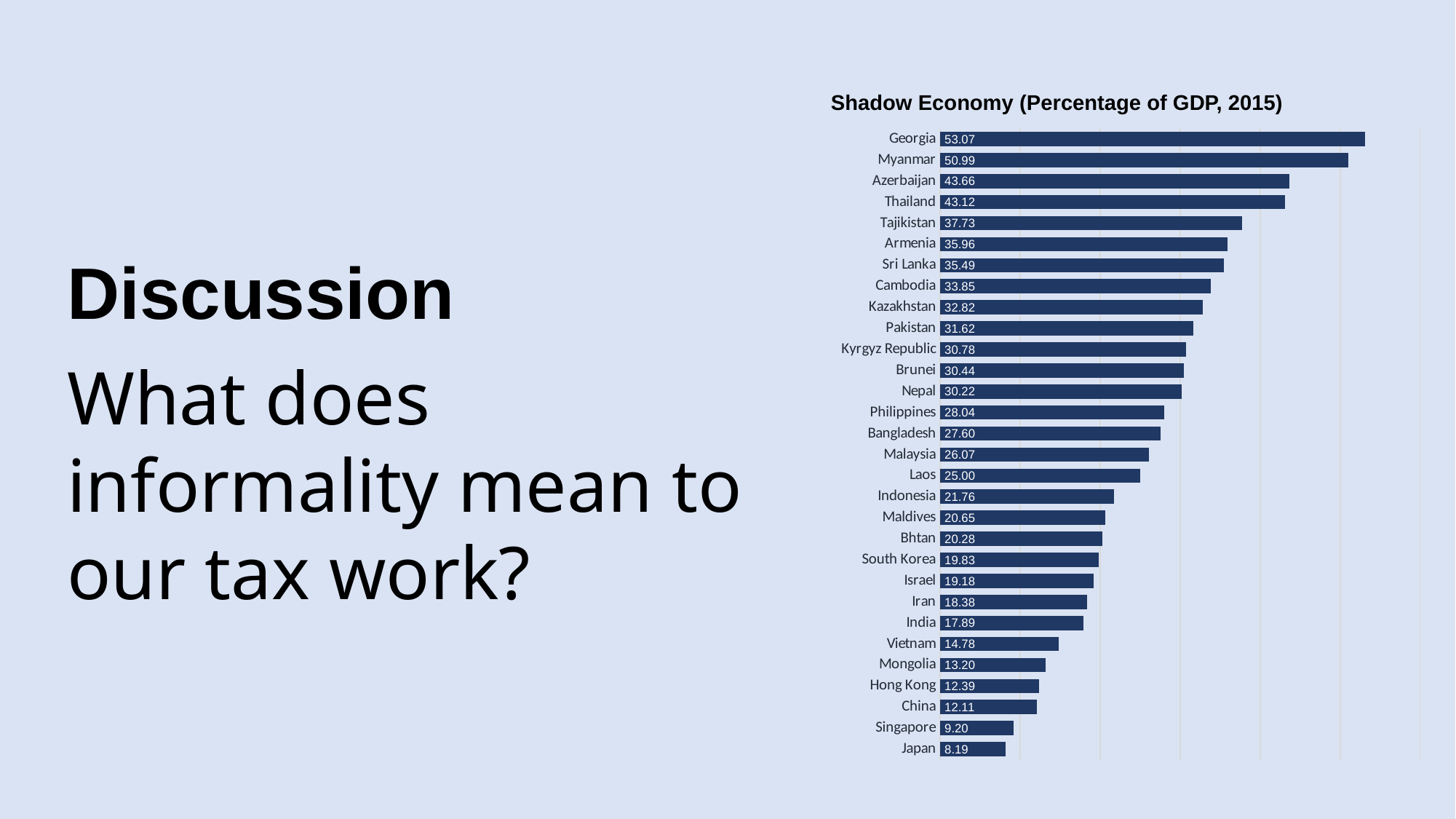
How many countries are shown in the Shadow Economy chart? 30 Which has a larger value, Mongolia or Indonesia? Indonesia What is the difference between the values for Thailand and Tajikistan? 5.39 Which country has the lowest shadow economy percentage in the chart? Japan Which has a larger value, Myanmar or Azerbaijan? Myanmar What kind of chart is shown on the slide? Bar chart What is the title of the chart on the slide? Shadow Economy (Percentage of GDP, 2015) What is the value for Laos in the Shadow Economy chart? 25.00 Which country has the highest shadow economy percentage in the chart? Georgia What is the value for Vietnam in the Shadow Economy chart? 14.78 What is the value for Georgia in the Shadow Economy chart? 53.07 What is the difference between the values for Georgia and Japan? 44.88